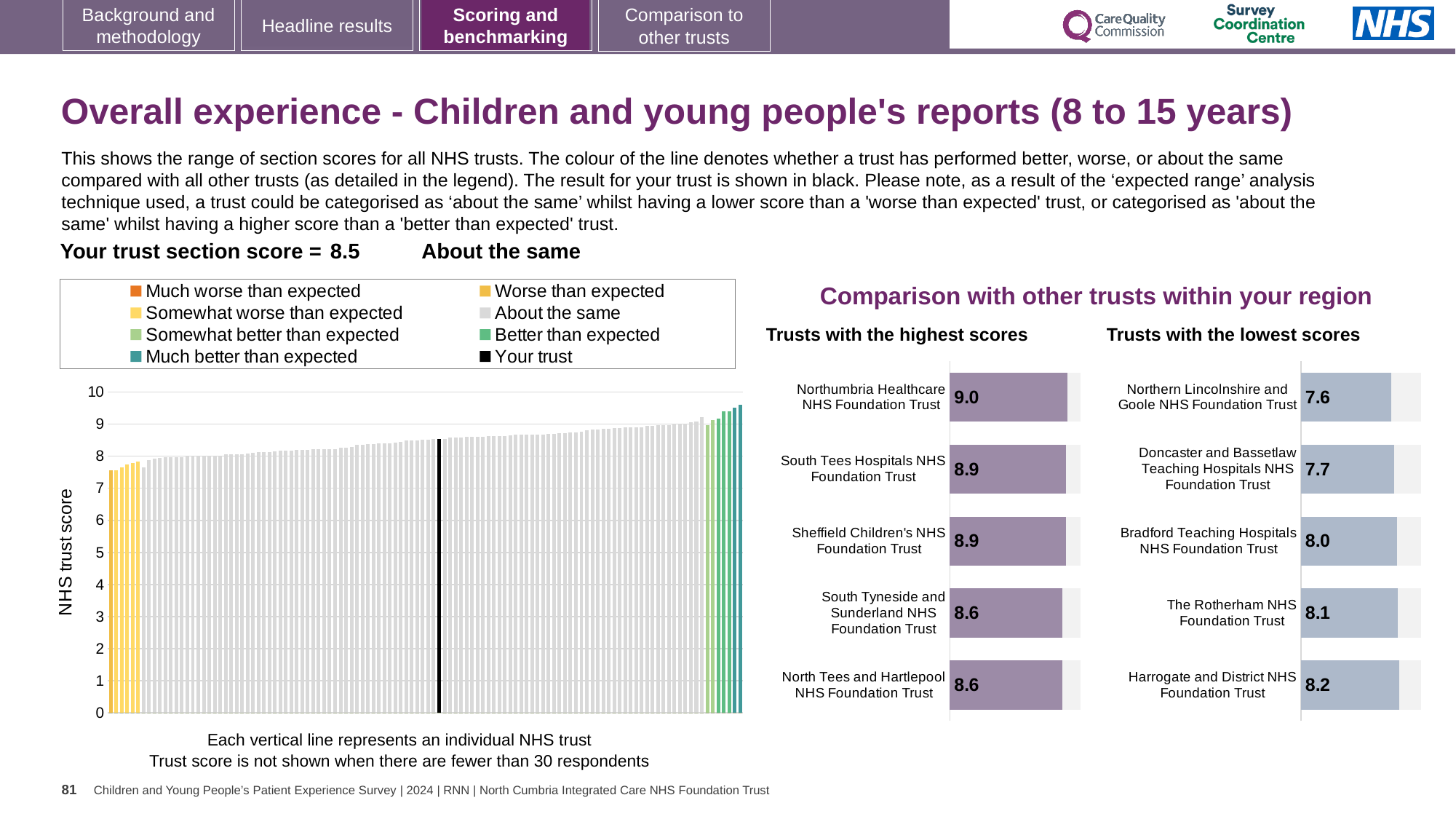
In the 'Trusts with the lowest scores' chart, what is the score for Bradford Teaching Hospitals NHS Foundation Trust? 8.0 In the 'Trusts with the lowest scores' chart, which has the larger score: Bradford Teaching Hospitals NHS Foundation Trust or The Rotherham NHS Foundation Trust? The Rotherham NHS Foundation Trust In the 'Trusts with the highest scores' chart, what is the difference between the scores of Northumbria Healthcare NHS Foundation Trust and South Tyneside and Sunderland NHS Foundation Trust? 0.4 In the 'Trusts with the lowest scores' chart, which trust has the lowest score? Northern Lincolnshire and Goole NHS Foundation Trust In the 'Trusts with the highest scores' chart, what is the score for Northumbria Healthcare NHS Foundation Trust? 9.0 In the 'Trusts with the highest scores' chart, which trust has the highest score? Northumbria Healthcare NHS Foundation Trust What kind of chart is the main NHS trust score chart on the left of the slide? Bar chart In the main NHS trust score chart on the left, is the value for your trust (the black bar) greater or less than 8? greater In the 'Trusts with the lowest scores' chart, what is the difference between the scores of Harrogate and District NHS Foundation Trust and Northern Lincolnshire and Goole NHS Foundation Trust? 0.6 In the main NHS trust score chart on the left, do the bar values rise or fall from left to right? Rise In the 'Trusts with the highest scores' chart, how many trusts are listed? 5 In the main NHS trust score chart on the left, how many entries does the legend list? 8